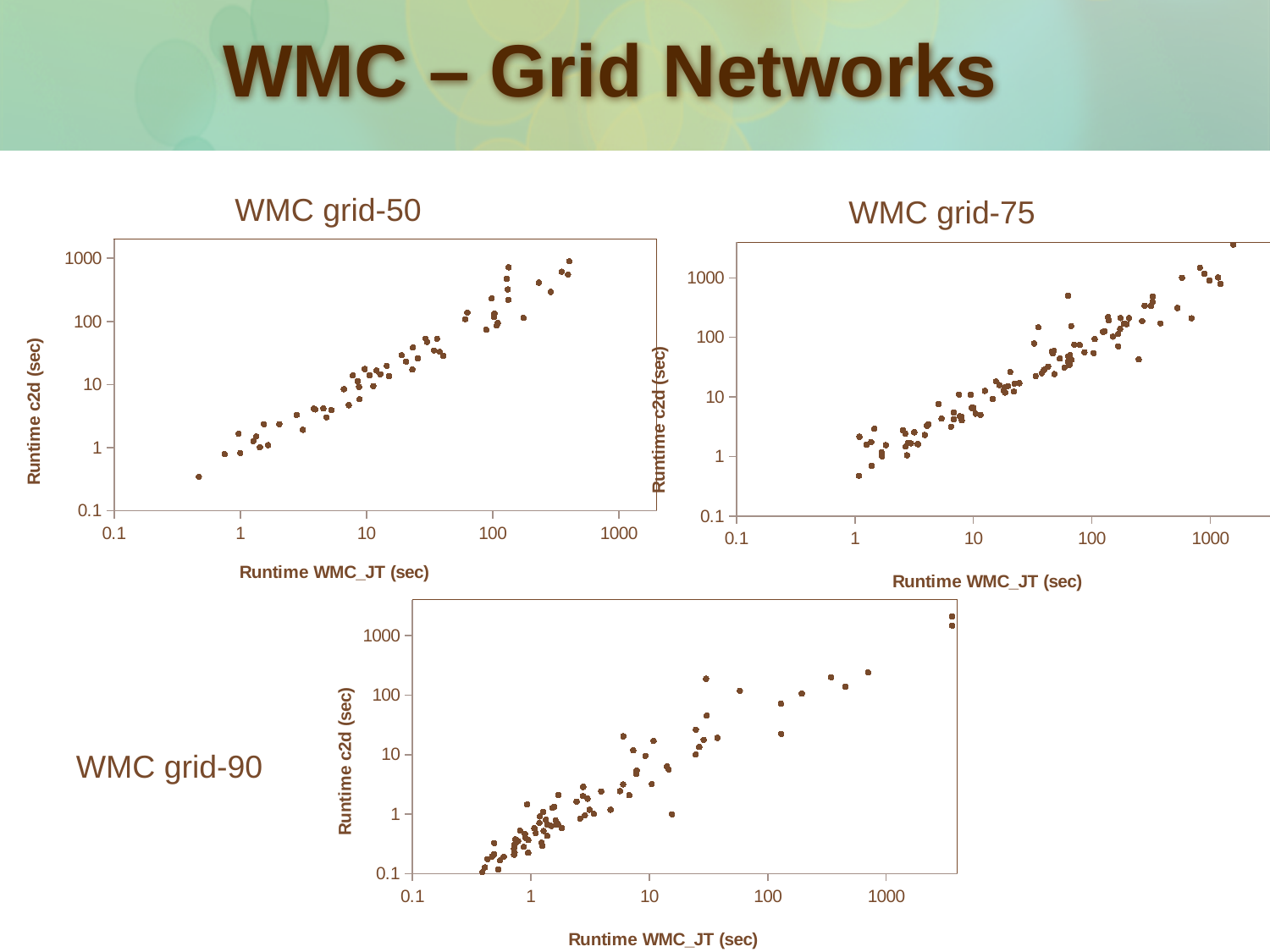
What is the y-axis label of the WMC grid-90 chart? Runtime c2d (sec) In the WMC grid-90 chart, is the highest Runtime c2d value greater or less than 1000? greater What is the x-axis label of the WMC grid-50 chart? Runtime WMC_JT (sec) In the WMC grid-75 chart, is the highest Runtime c2d value greater or less than 1000? greater How many charts are shown on the slide? 3 In the WMC grid-90 chart, do the Runtime c2d values generally rise or fall as Runtime WMC_JT increases? rise In the WMC grid-50 chart, is the highest Runtime WMC_JT value greater or less than 100? greater What is the title of the chart at the bottom of the slide? WMC grid-90 In the WMC grid-75 chart, do the Runtime c2d values generally rise or fall as Runtime WMC_JT increases? rise What kind of chart is the WMC grid-50 chart? scatter plot